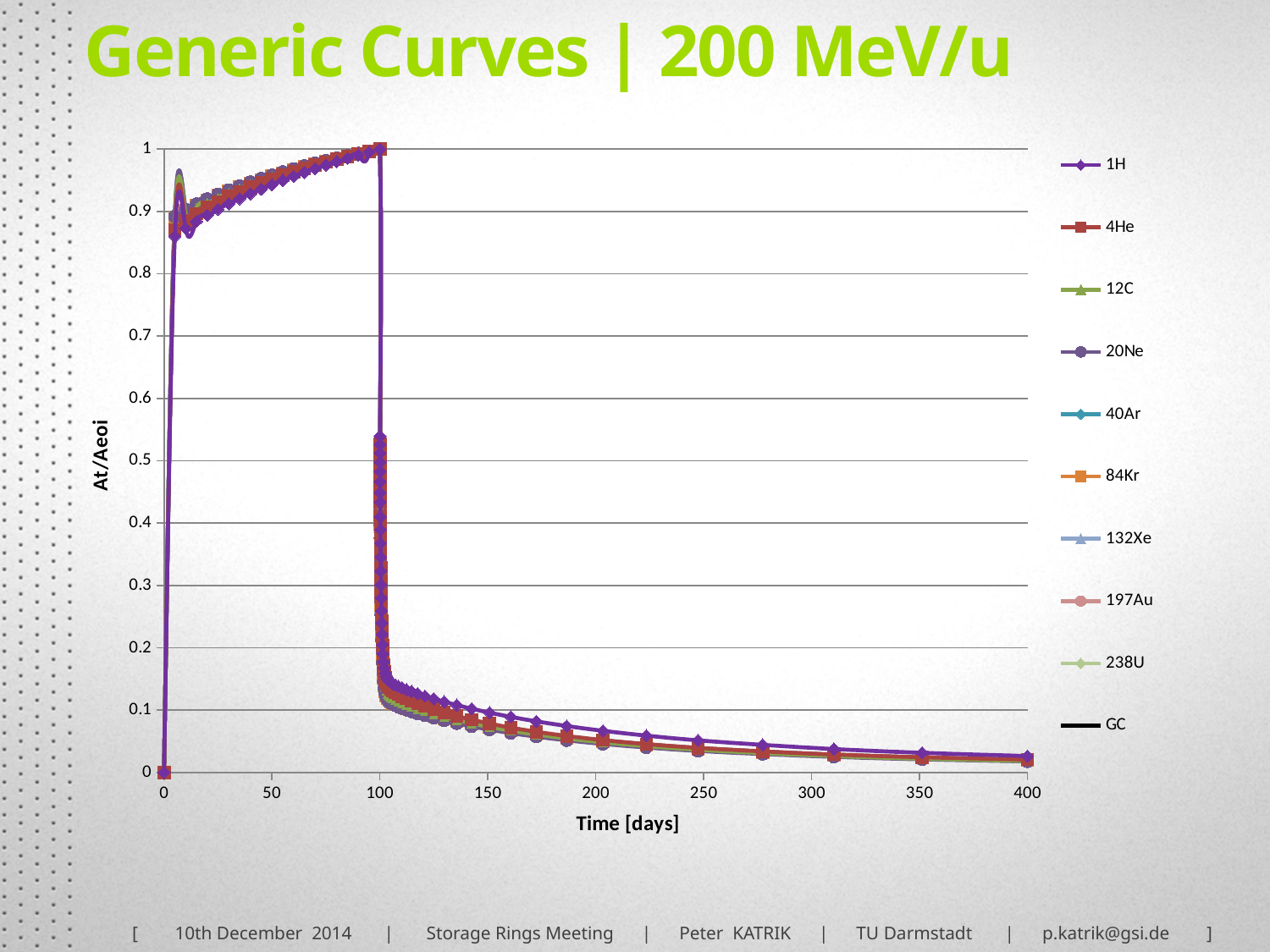
What is the title of the chart? Generic Curves | 200 MeV/u Is the value for 4He at 100 days, just before the drop, greater or less than 0.9? greater Is the value for 1H at 200 days greater or less than 0.1? less Is the value for 4He at 400 days greater or less than 0.1? less Do the curves rise or fall between 20 and 100 days? rise What is the highest value shown on the x axis (Time [days])? 400 What is the label of the y axis? At/Aeoi What kind of chart is shown on the slide? line chart Do the curves rise or fall between 150 and 400 days? fall How many series does the legend list? 10